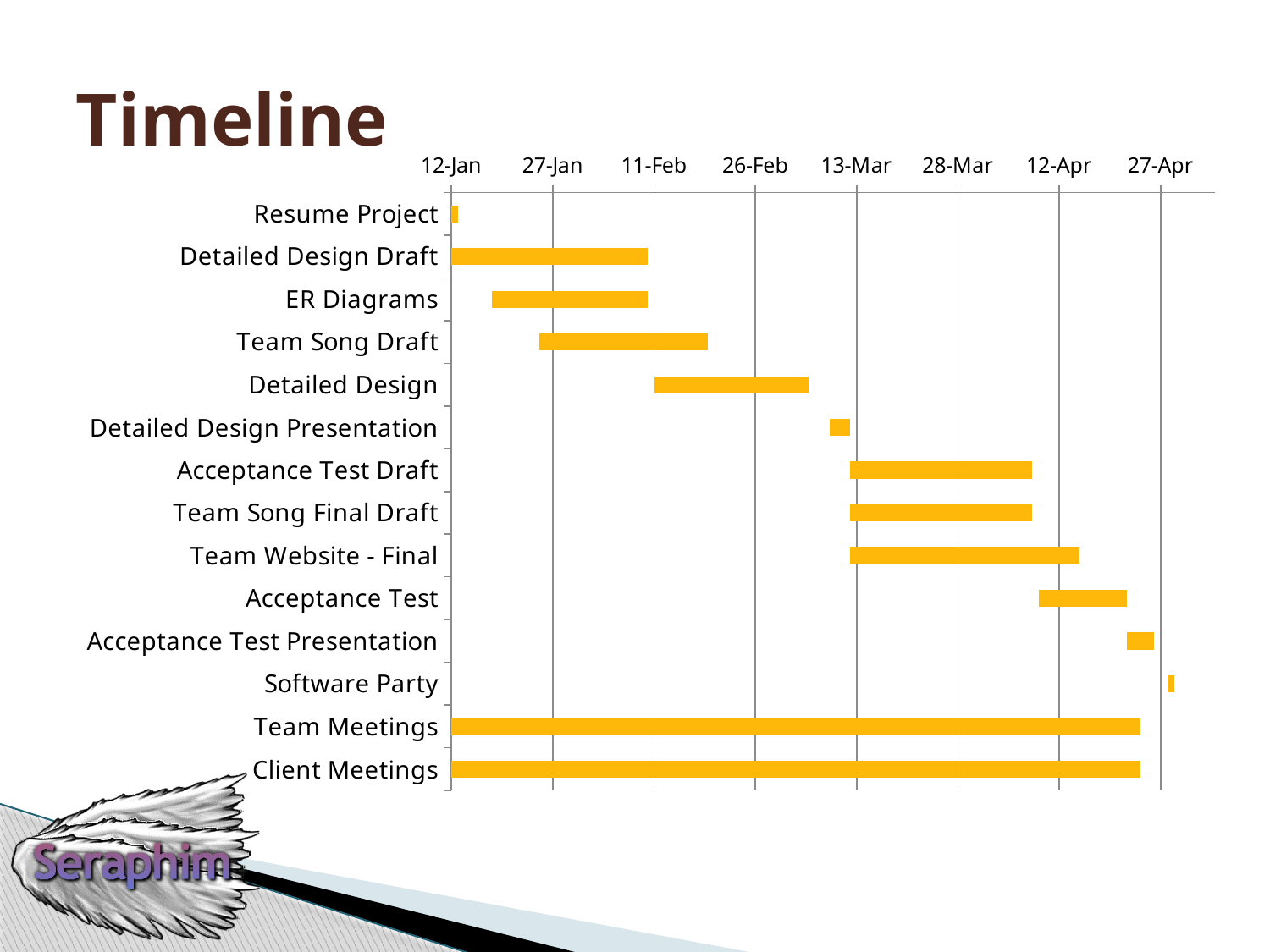
Which task is listed first (at the top) on the chart? Resume Project How many tasks are listed on the vertical axis of the chart? 14 What is the title of the slide containing the chart? Timeline Which task is listed last (at the bottom) on the chart? Client Meetings Does the Team Song Draft bar end before or after 11-Feb? after What kind of chart is shown on the slide? Bar chart (Gantt-style horizontal bars) Which bar is longer: Detailed Design Draft or Detailed Design Presentation? Detailed Design Draft Which bar is longer: Team Website - Final or Acceptance Test? Team Website - Final Does the Software Party bar fall before or after 27-Apr? after Does the Acceptance Test bar start before or after 12-Apr? before What is the first date label shown on the horizontal axis? 12-Jan Which task's bar starts at the 11-Feb tick? Detailed Design